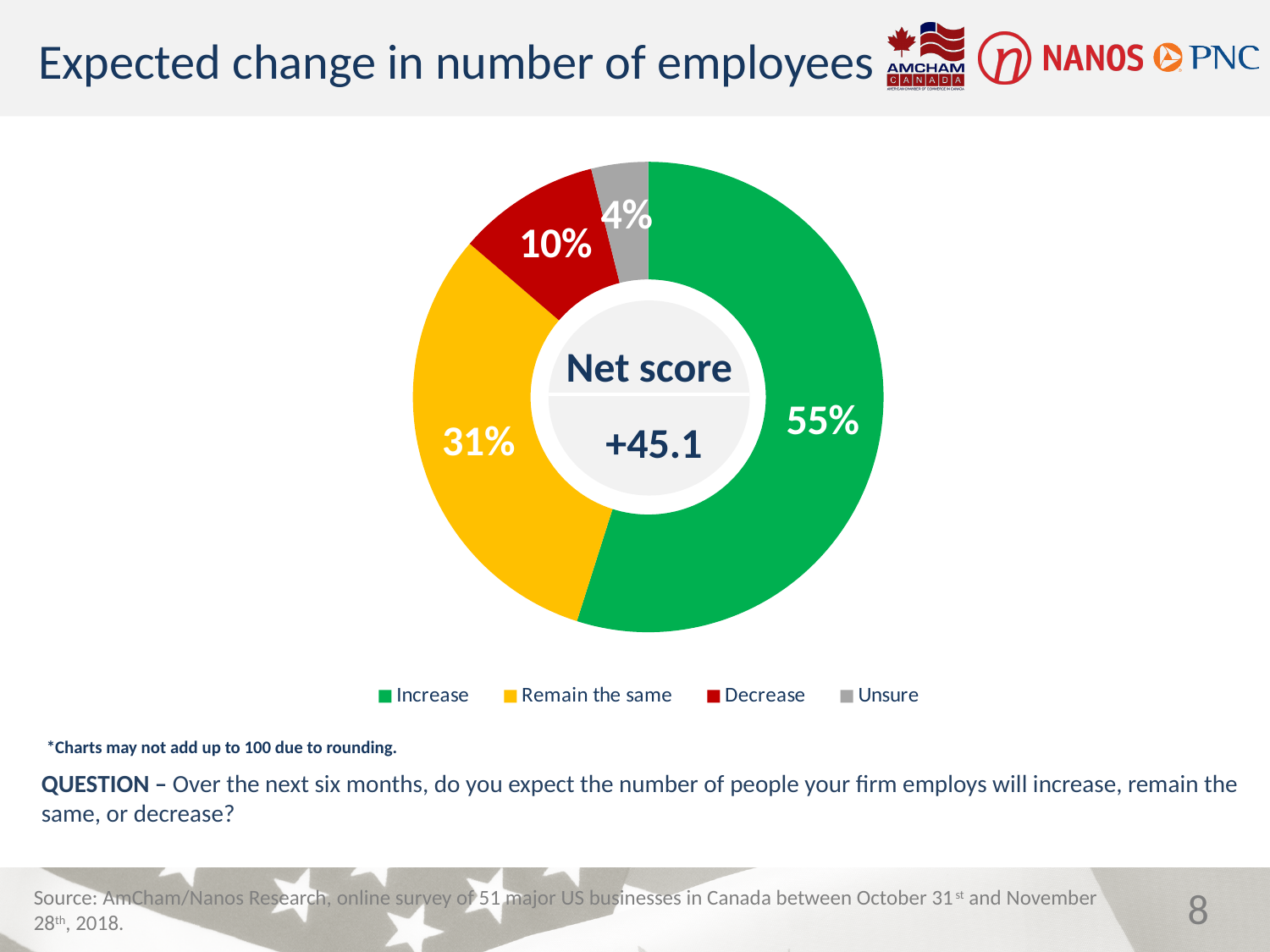
What colour represents the Remain the same category in the chart? Yellow How many response categories does the chart show? 4 What percentage of respondents expect the number of employees to decrease? 10% Which response category has the largest share of the chart? Increase What net score is shown in the centre of the chart? +45.1 What percentage of respondents expect the number of employees to increase? 55% What is the difference in percentage points between Increase and Remain the same? 24 Which response category has the smallest share of the chart? Unsure What percentage of respondents are unsure about the expected change in number of employees? 4% What kind of chart is shown on the slide? Pie chart (doughnut) What percentage of respondents expect the number of employees to remain the same? 31% Which is larger, the share for Decrease or the share for Unsure? Decrease